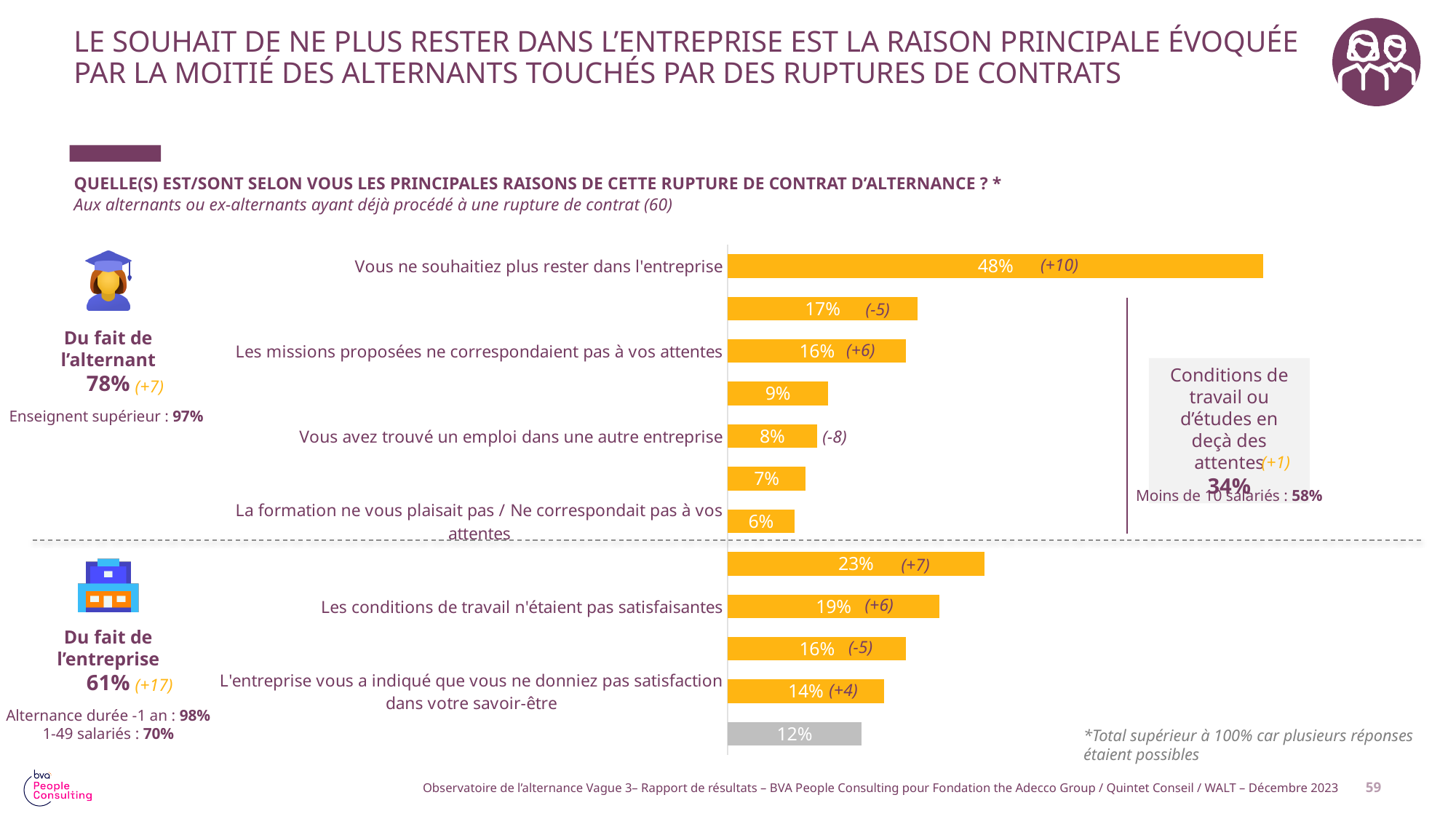
What is the value for 'Les missions proposées ne correspondaient pas à vos attentes'? 16% What is the value for 'Les conditions de travail n'étaient pas satisfaisantes'? 19% What is the value for 'L'entreprise vous a indiqué que vous ne donniez pas satisfaction dans votre savoir-être'? 14% Which is larger: 'Les missions proposées ne correspondaient pas à vos attentes' or 'Vous avez trouvé un emploi dans une autre entreprise'? Les missions proposées ne correspondaient pas à vos attentes Which reason has the highest value in the chart? Vous ne souhaitiez plus rester dans l'entreprise What is the difference between 'Vous ne souhaitiez plus rester dans l'entreprise' and 'Les conditions de travail n'étaient pas satisfaisantes'? 29% How many bars are plotted in the chart? 12 What kind of chart is shown on the slide? Bar chart What is the value for 'La formation ne vous plaisait pas / Ne correspondait pas à vos attentes'? 6% What is the value for 'Vous ne souhaitiez plus rester dans l'entreprise'? 48% What colour is the bottom bar labelled 12%? Grey What is the value for 'Vous avez trouvé un emploi dans une autre entreprise'? 8%